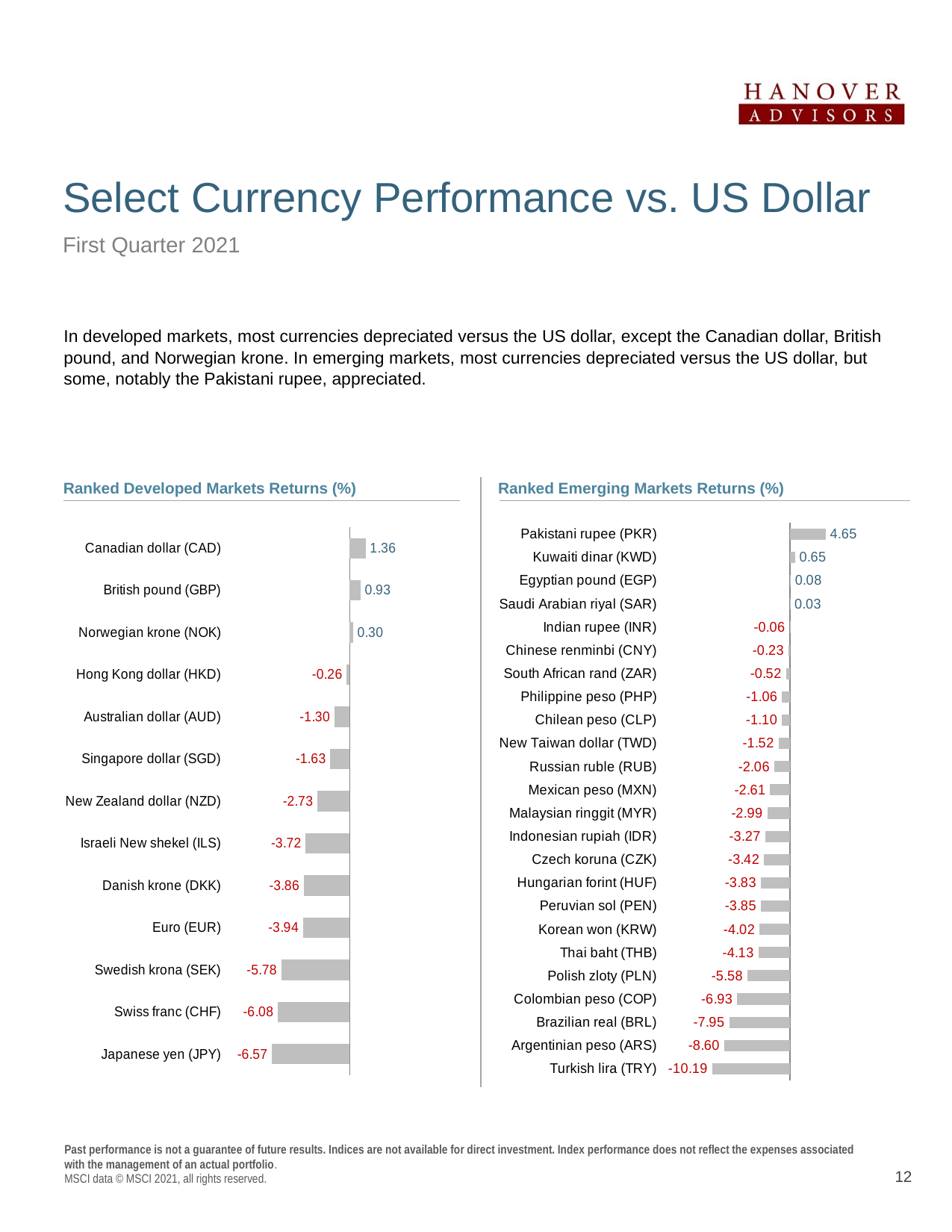
How many currencies are shown in the Ranked Emerging Markets Returns (%) chart? 24 In the Ranked Emerging Markets Returns (%) chart, which currency has the highest return? Pakistani rupee (PKR) In the Ranked Emerging Markets Returns (%) chart, what is the difference between the Pakistani rupee (PKR) and the Kuwaiti dinar (KWD) values? 4.00 In the Ranked Developed Markets Returns (%) chart, which currency has the lowest return? Japanese yen (JPY) In the Ranked Developed Markets Returns (%) chart, what is the value for the Canadian dollar (CAD)? 1.36 In the Ranked Emerging Markets Returns (%) chart, which is larger, the value for the Russian ruble (RUB) or the Mexican peso (MXN)? Russian ruble (RUB) What type of chart is the Ranked Emerging Markets Returns (%) chart? Bar chart How many currencies are shown in the Ranked Developed Markets Returns (%) chart? 13 In the Ranked Emerging Markets Returns (%) chart, what is the value for the Turkish lira (TRY)? -10.19 In the Ranked Developed Markets Returns (%) chart, what is the value for the Euro (EUR)? -3.94 In the Ranked Developed Markets Returns (%) chart, what is the difference between the Canadian dollar (CAD) and the British pound (GBP) values? 0.43 In the Ranked Developed Markets Returns (%) chart, which is larger, the value for the Swedish krona (SEK) or the Swiss franc (CHF)? Swedish krona (SEK)